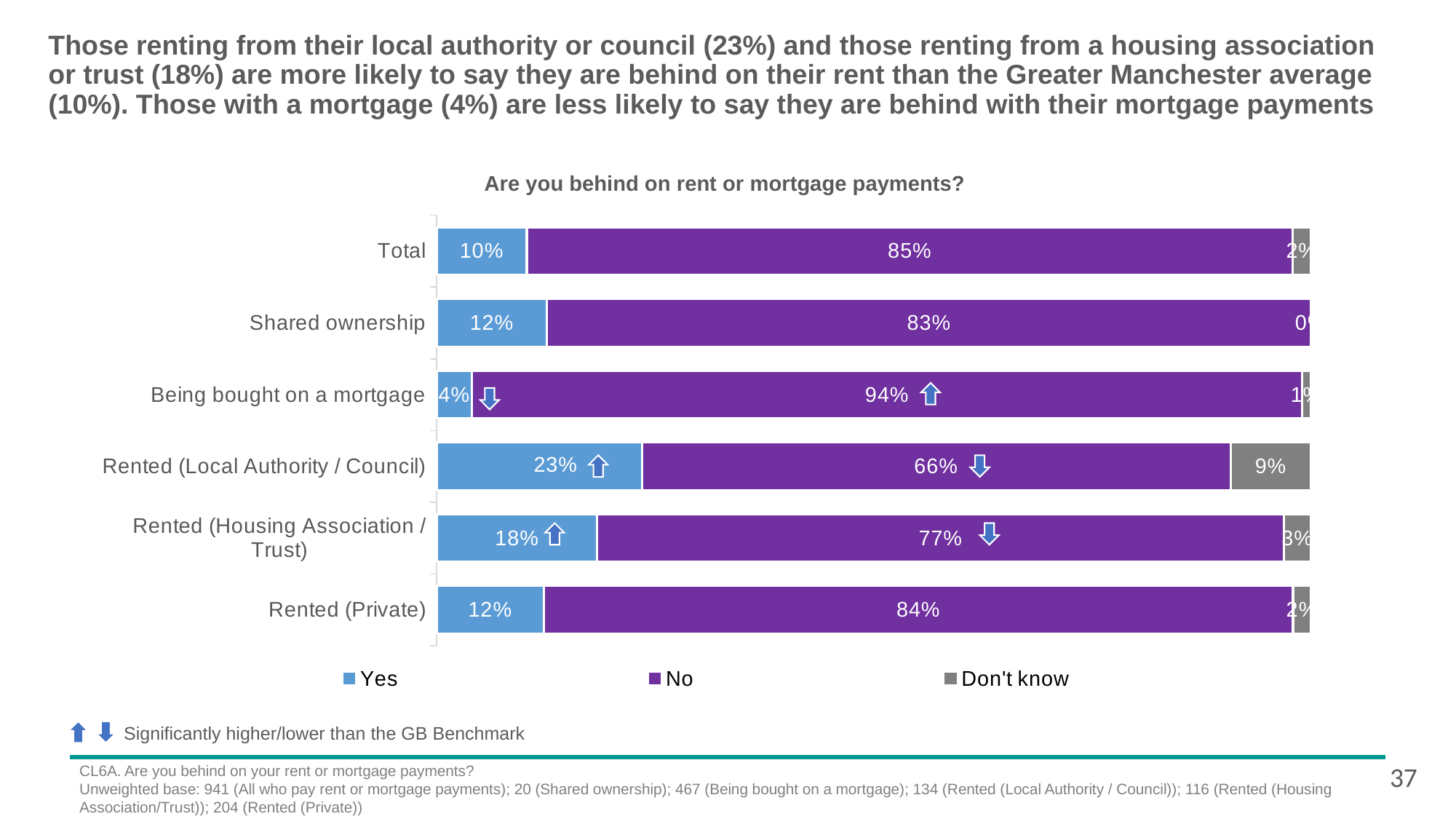
What is the 'No' value for Being bought on a mortgage? 94% Which has the larger 'No' value, Total or Rented (Local Authority / Council)? Total Which category has the lowest 'No' value? Rented (Local Authority / Council) What is the 'Yes' value for Rented (Housing Association / Trust)? 18% What kind of chart is shown on the slide? Bar chart What is the difference between the 'Yes' values for Rented (Local Authority / Council) and Rented (Housing Association / Trust)? 5% How many series does the legend list? 3 Which category has the highest 'Yes' value? Rented (Local Authority / Council) How many categories are shown on the chart? 6 What is the 'Don't know' value for Rented (Local Authority / Council)? 9% What is the 'Yes' value for Rented (Local Authority / Council)? 23% Which category has the lowest 'Yes' value? Being bought on a mortgage